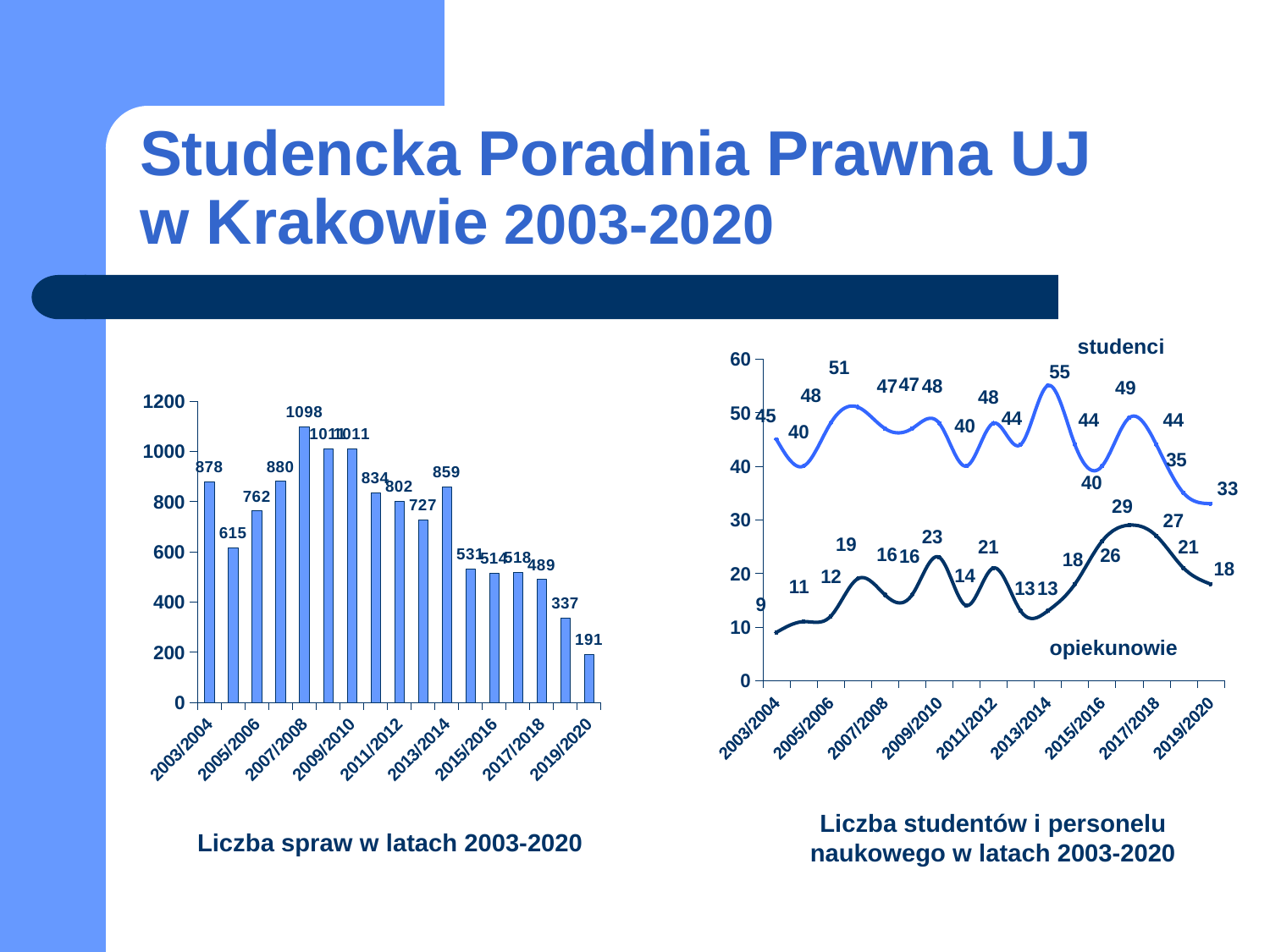
In the right chart, what is the value of the 'opiekunowie' series for 2003/2004? 9 How many bars are plotted in the left chart 'Liczba spraw w latach 2003-2020'? 17 What kind of chart is the right chart, 'Liczba studentów i personelu naukowego w latach 2003-2020'? line chart In the right chart, what is the highest value of the 'studenci' series? 55 What kind of chart is the left chart, 'Liczba spraw w latach 2003-2020'? bar chart In the left chart 'Liczba spraw w latach 2003-2020', which is larger, the value for 2009/2010 or for 2011/2012? 2009/2010 How many series are shown in the right chart 'Liczba studentów i personelu naukowego w latach 2003-2020'? 2 In the left chart 'Liczba spraw w latach 2003-2020', what is the value for 2007/2008? 1098 In the left chart 'Liczba spraw w latach 2003-2020', which year has the lowest value? 2019/2020 In the left chart 'Liczba spraw w latach 2003-2020', which year has the highest value? 2007/2008 In the left chart 'Liczba spraw w latach 2003-2020', what is the difference between the values for 2003/2004 and 2019/2020? 687 In the left chart 'Liczba spraw w latach 2003-2020', do the values rise or fall from 2013/2014 to 2019/2020? fall